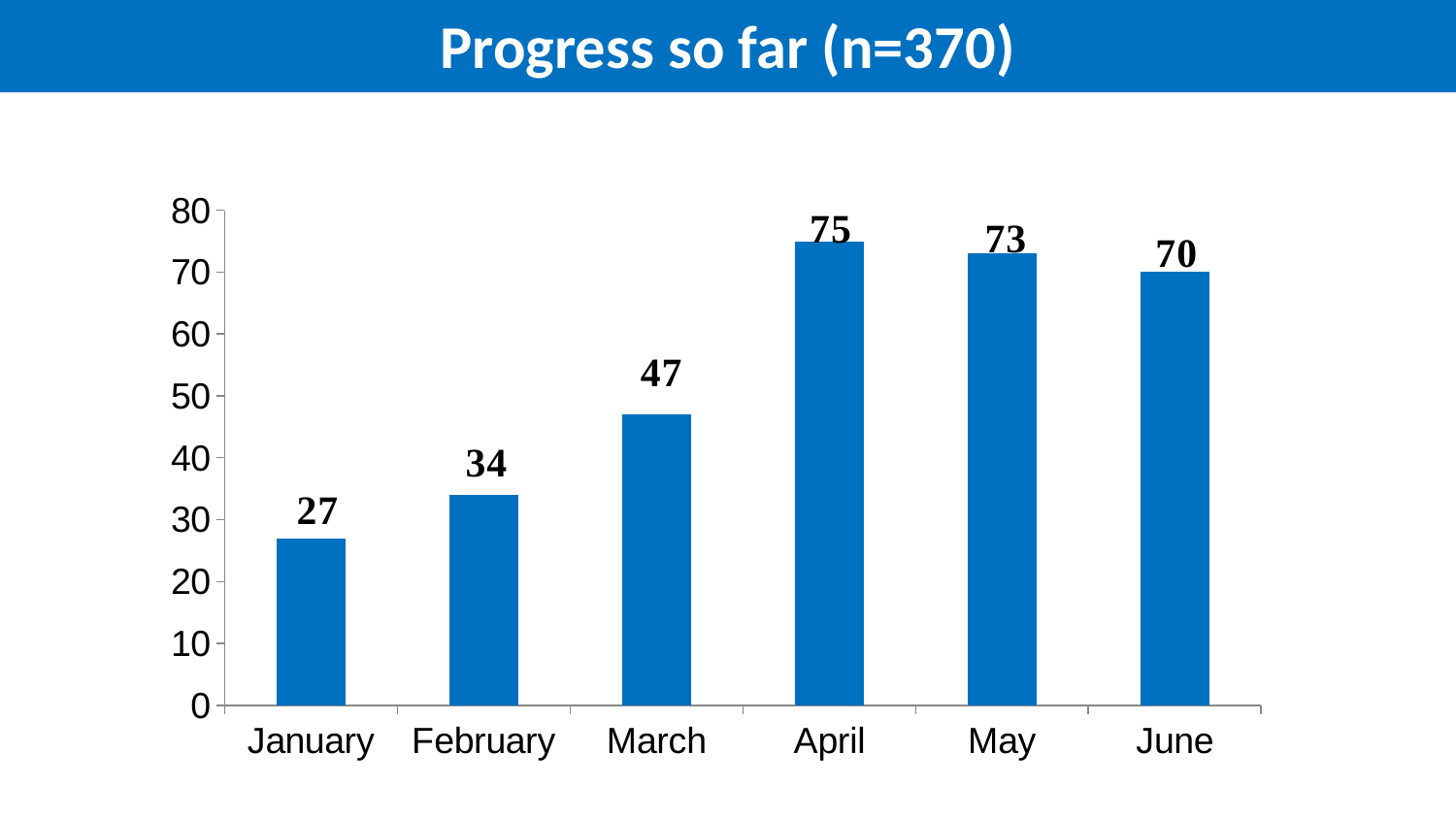
What is the value for March? 47 What is the difference between the values for March and February? 13 Which month has the lowest value? January Which is larger, the value for May or the value for June? May Is the value for February greater or less than 40? less What is the title of the slide? Progress so far (n=370) Which month has the highest value? April What is the difference between the values for April and January? 48 What kind of chart is shown on the slide? bar chart What is the value for January? 27 How many months are shown on the x axis? 6 What is the value for April? 75